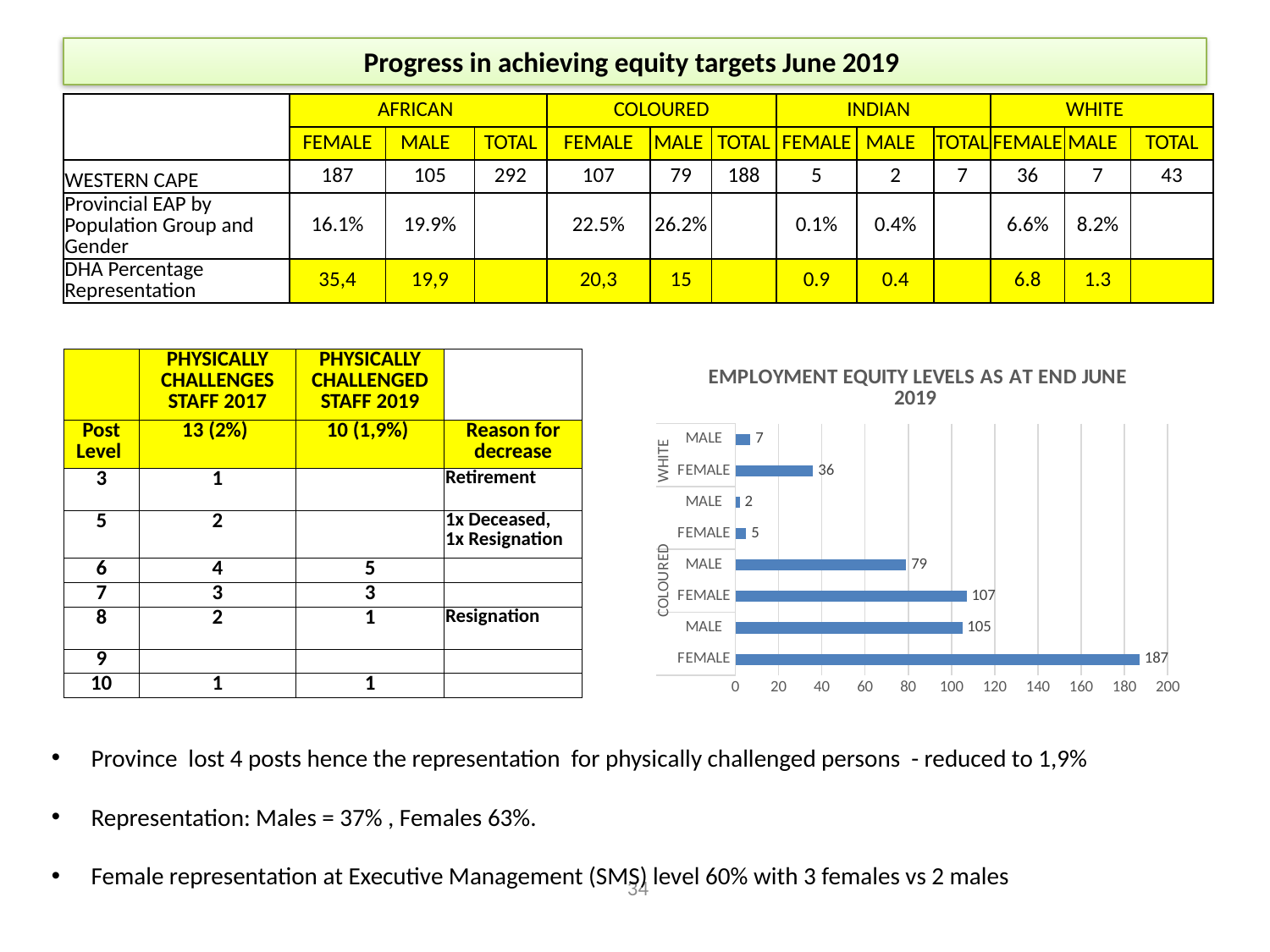
In the chart, which is larger, COLOURED MALE or WHITE FEMALE? COLOURED MALE In the chart, what is the difference between COLOURED FEMALE and COLOURED MALE? 28 In the chart, what is the value for WHITE FEMALE? 36 What is the title of the chart on the slide? EMPLOYMENT EQUITY LEVELS AS AT END JUNE 2019 In the chart, what is the value of the bottom bar (FEMALE)? 187 In the chart, what is the difference between WHITE FEMALE and WHITE MALE? 29 How many bars are plotted in the chart? 8 In the chart, is the value for COLOURED FEMALE greater or less than 100? greater What type of chart is shown on the slide? bar chart In the chart, what is the value for COLOURED FEMALE? 107 In the chart, what is the value for WHITE MALE? 7 In the chart, what is the value for COLOURED MALE? 79